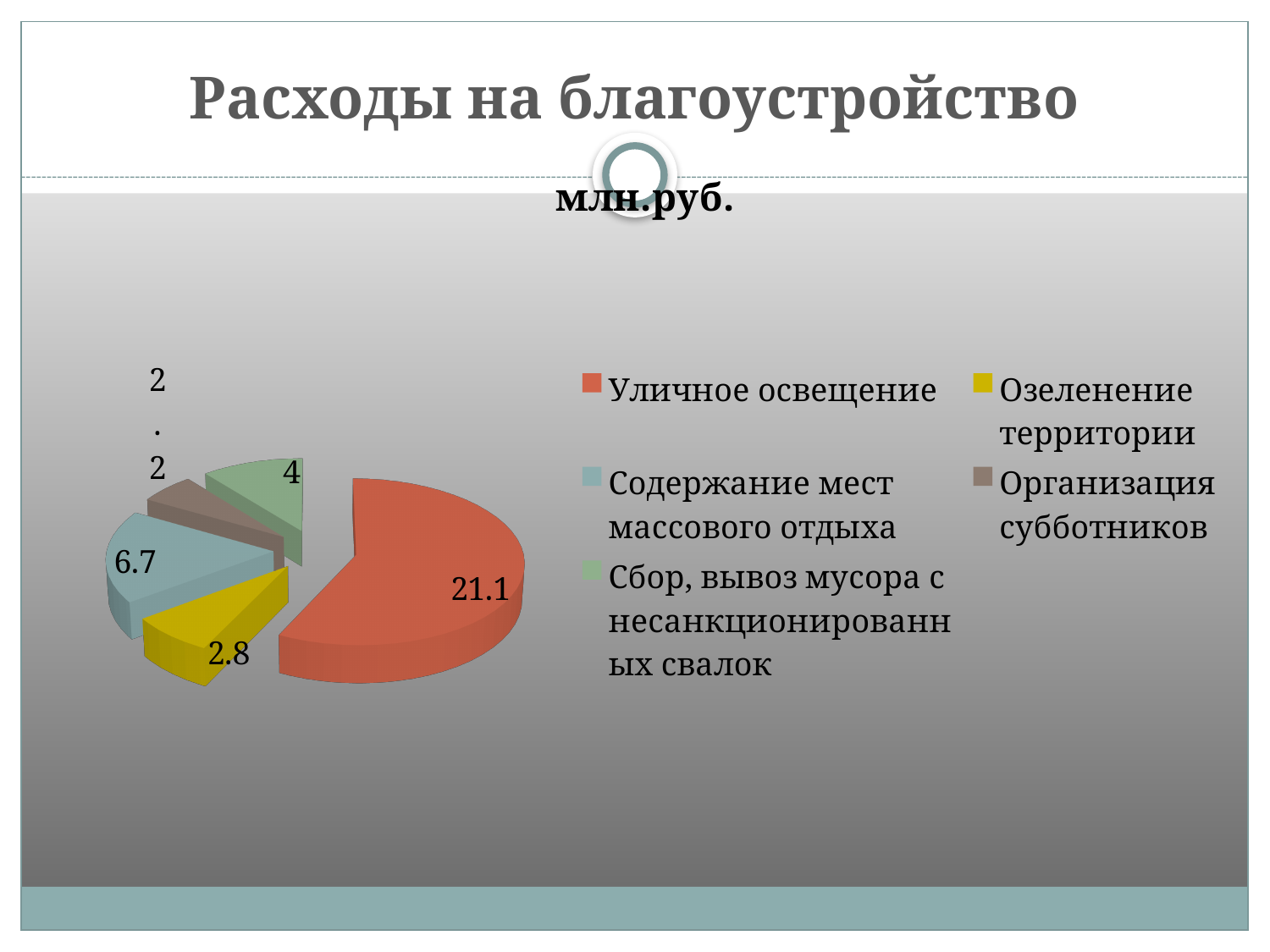
What is the title shown above the pie chart? млн.руб. Which is larger: the value for Озеленение территории or the value for Сбор, вывоз мусора с несанкционированных свалок? Сбор, вывоз мусора с несанкционированных свалок Which category has the largest slice of the pie? Уличное освещение What is the value for Озеленение территории? 2.8 Which category has the smallest slice of the pie? Организация субботников What is the value for Содержание мест массового отдыха? 6.7 What is the value for Уличное освещение? 21.1 What is the value for Сбор, вывоз мусора с несанкционированных свалок? 4 How many categories (slices) does the pie chart have? 5 What type of chart is shown on the slide? Pie chart What is the difference between the values for Содержание мест массового отдыха and Сбор, вывоз мусора с несанкционированных свалок? 2.7 What is the difference between the values for Уличное освещение and Содержание мест массового отдыха? 14.4